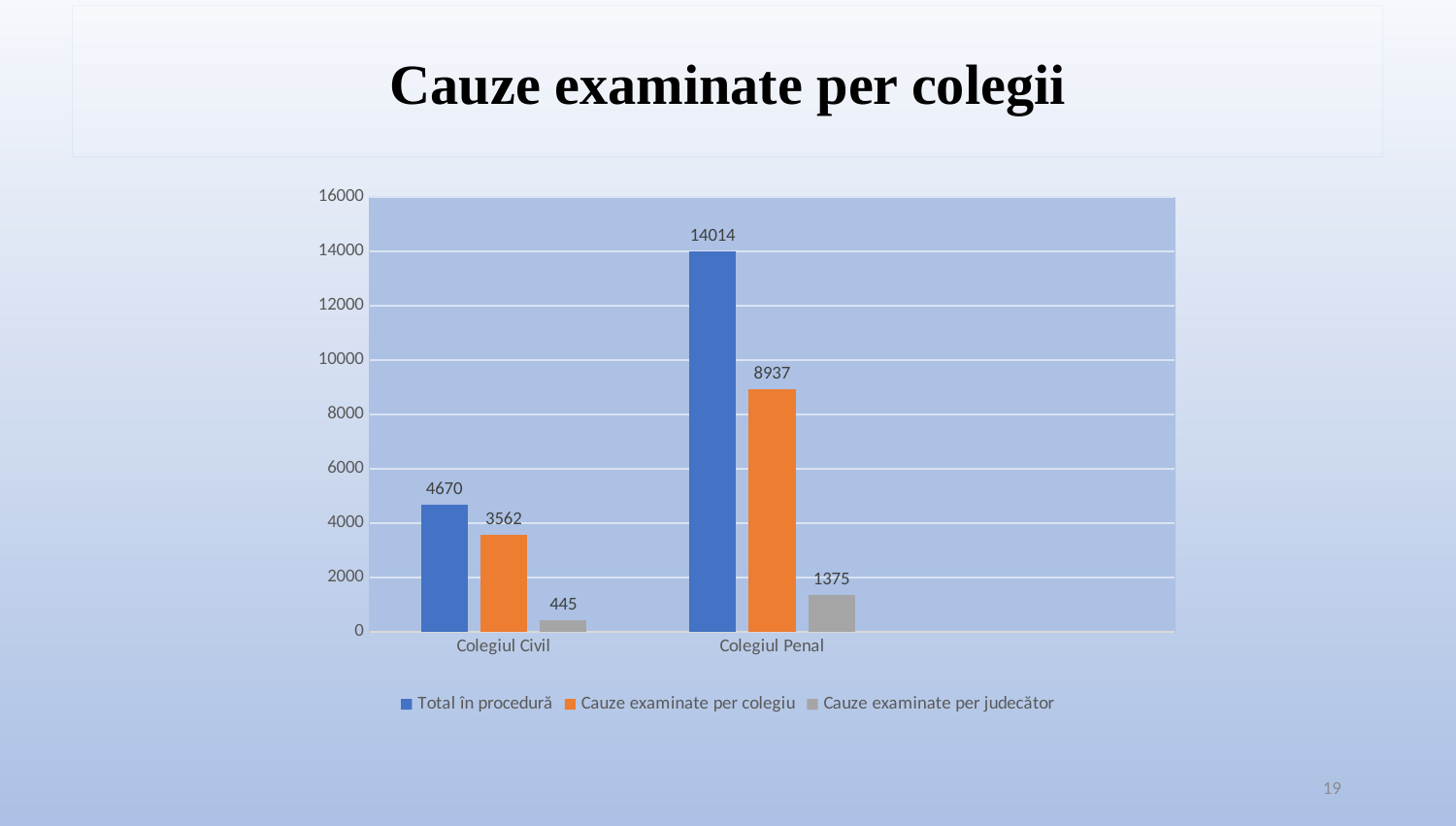
What is the difference between 'Total în procedură' for Colegiul Penal and Colegiul Civil? 9344 Which category has the lowest 'Cauze examinate per judecător' value? Colegiul Civil Which category has the highest 'Total în procedură' value? Colegiul Penal How many categories are shown on the x axis? 2 What is the value of 'Cauze examinate per judecător' for Colegiul Civil? 445 How many series does the legend list? 3 What is the value of 'Cauze examinate per colegiu' for Colegiul Penal? 8937 Is the 'Cauze examinate per colegiu' value for Colegiul Penal greater or less than 8000? greater What is the value of 'Total în procedură' for Colegiul Civil? 4670 Which is larger: 'Cauze examinate per colegiu' for Colegiul Civil or 'Cauze examinate per judecător' for Colegiul Penal? Cauze examinate per colegiu for Colegiul Civil What kind of chart is shown on the slide? bar chart What is the value of 'Total în procedură' for Colegiul Penal? 14014